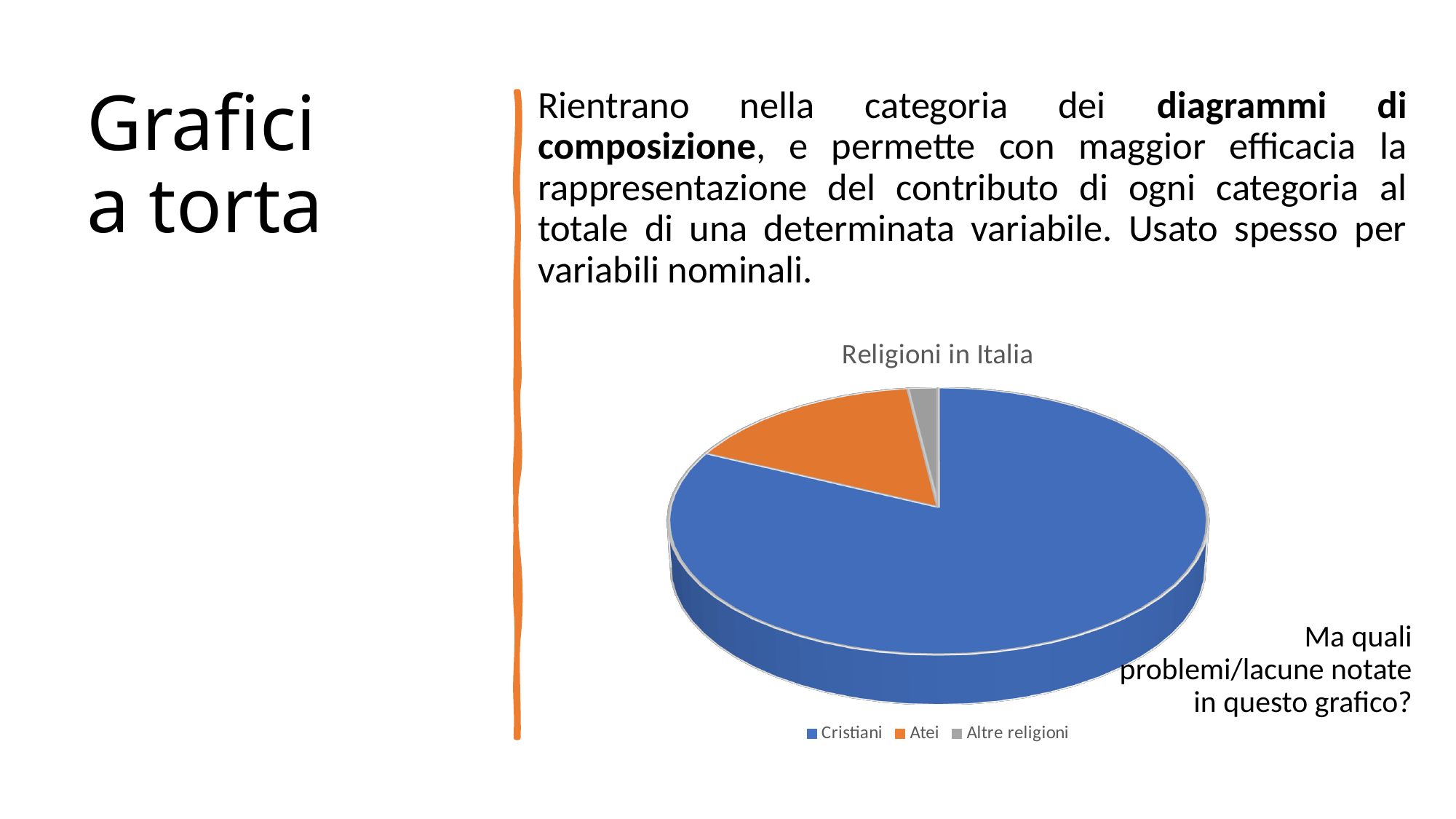
How many entries does the chart legend list? 3 Which slice is larger, Cristiani or Atei? Cristiani Which category has the smallest slice of the pie? Altre religioni Which colour represents Atei in the pie chart? orange Which category has the largest slice of the pie? Cristiani What is the title of the chart? Religioni in Italia Which slice is larger, Atei or Altre religioni? Atei How many slices does the pie chart have? 3 Does the Cristiani slice account for more or less than half of the pie? more What kind of chart is shown on the slide? pie chart